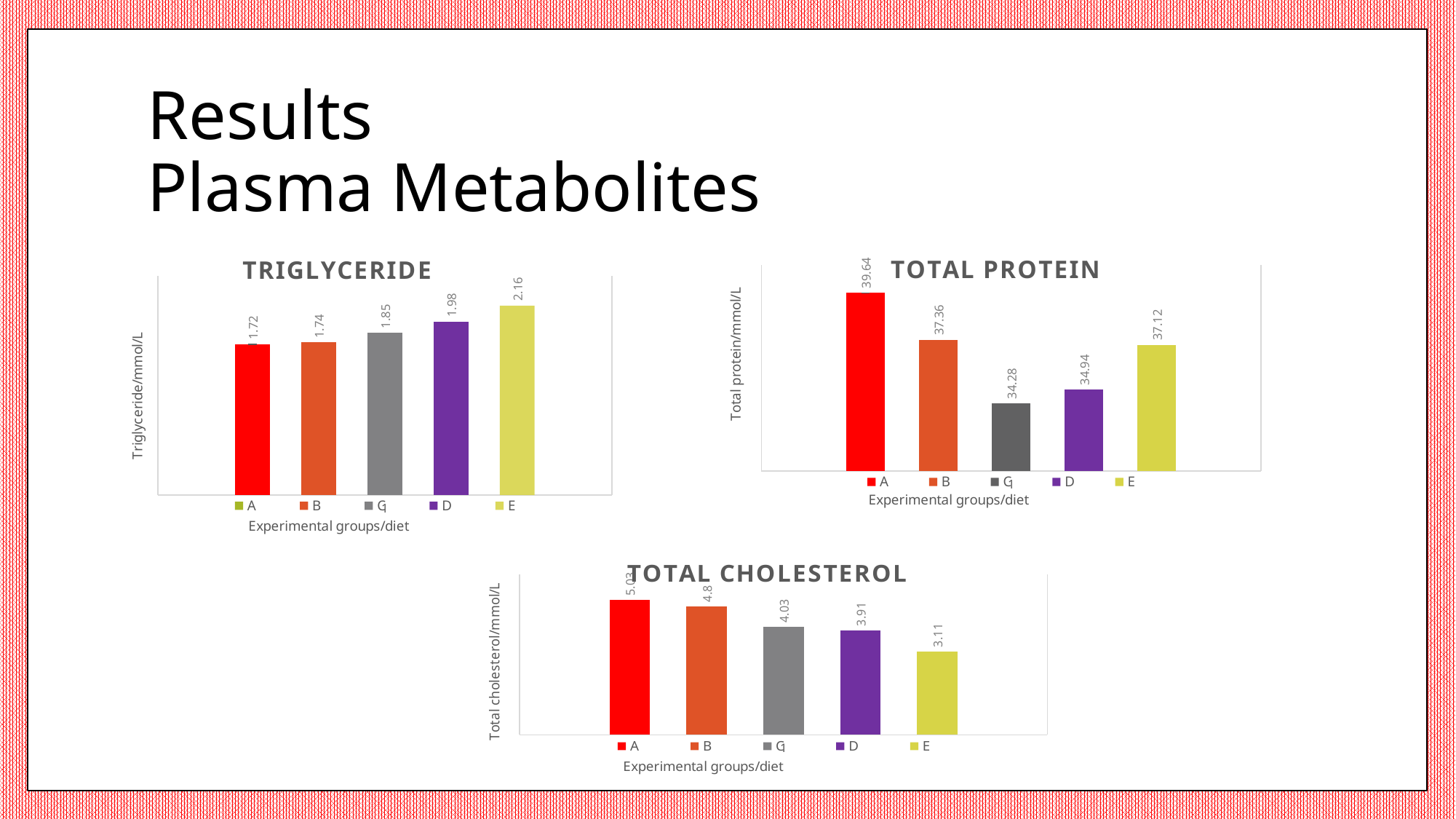
In the Total Protein chart, what is the difference between the values for group A and group C? 5.36 In the Total Cholesterol chart, what is the value for group E? 3.11 In the Total Protein chart, which group has the highest value? A What kind of chart is the Total Protein chart? bar chart In the Triglyceride chart, which group has the lowest value? A In the Total Protein chart, what is the value for group C? 34.28 In the Total Protein chart, which is larger, the value for group B or the value for group E? B In the Triglyceride chart, what is the difference between the values for group D and group A? 0.26 In the Total Cholesterol chart, which group has the lowest value? E In the Triglyceride chart, do the values rise or fall from group A to group E? rise How many groups are shown in the Total Cholesterol chart? 5 In the Triglyceride chart, what is the value for group E? 2.16